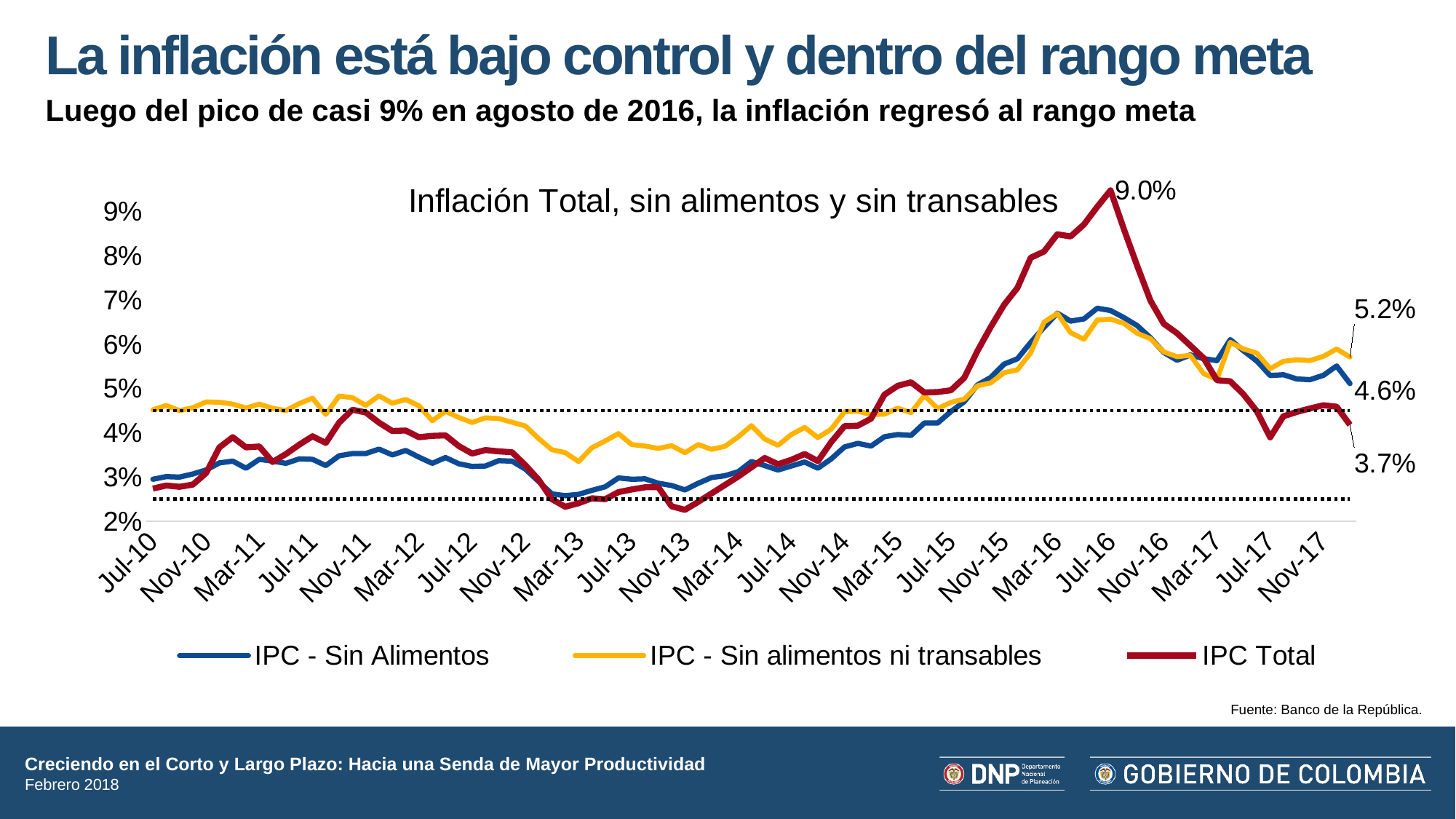
What is the title of the chart? Inflación Total, sin alimentos y sin transables Which series reaches the highest value anywhere on the chart? IPC Total At the right end of the chart, which series has the higher labelled value: IPC Total or IPC - Sin Alimentos? IPC - Sin Alimentos How many series does the legend of the chart list? 3 What type of chart is shown on the slide? Line chart By how many percentage points did IPC Total fall from its labelled peak of 9.0% to its labelled final value of 3.7%? 5.3 percentage points What is the labelled final value of the IPC - Sin alimentos ni transables series at the right end of the chart? 5.2% Does the IPC Total series rise or fall between Jul-16 and Nov-17? Fall Is the value of IPC Total around Jul-16 greater or less than 8%? greater What is the labelled final value of the IPC Total series at the right end of the chart? 3.7% What is the labelled peak value of the IPC Total series? 9.0% What is the labelled final value of the IPC - Sin Alimentos series at the right end of the chart? 4.6%